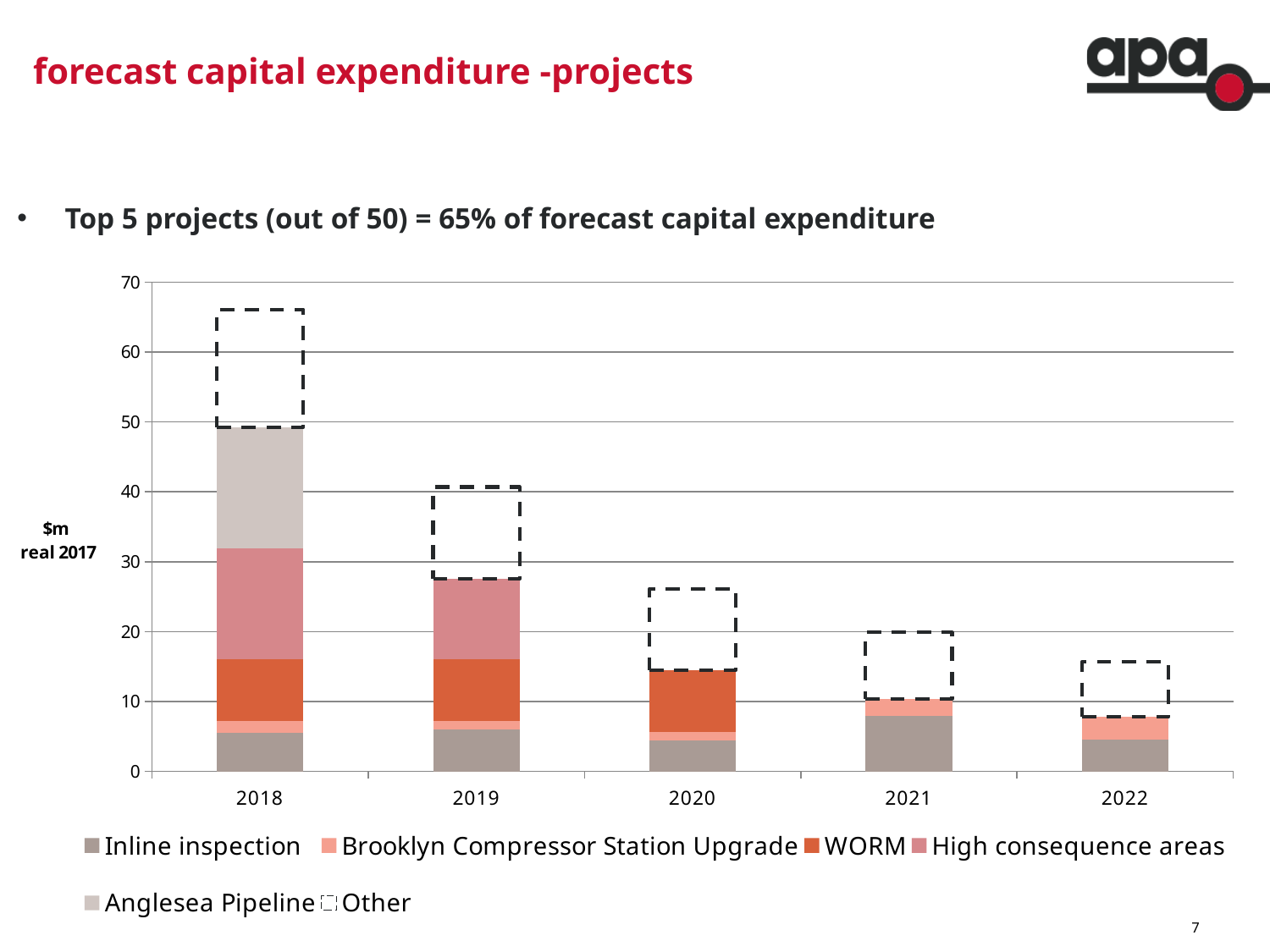
How many years are shown on the x axis of the chart? 5 Is the total value for 2020 greater or less than 30? less Which year has the highest total forecast capital expenditure? 2018 Which legend series is drawn with a dashed outline rather than a solid fill? Other What kind of chart is shown on the slide? Stacked bar chart Is the total value for 2018 greater or less than 60? greater Is the total value for 2021 greater or less than 10? greater Which year has the larger total bar, 2019 or 2020? 2019 Do the total bar heights rise or fall from 2018 to 2022? Fall How many series does the chart's legend list? 6 Which year has the lowest total forecast capital expenditure? 2022